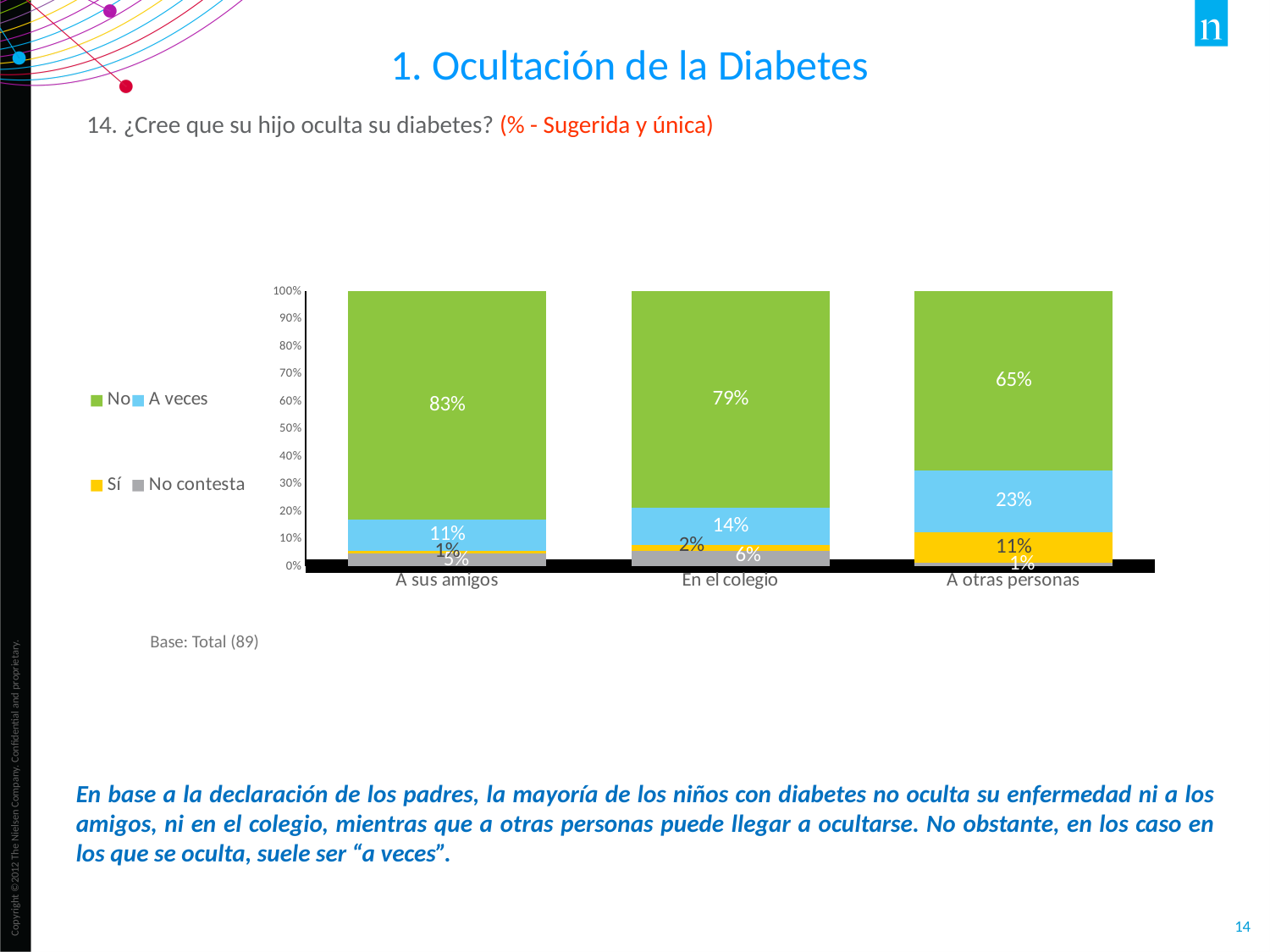
What is the value of 'No' for 'A otras personas'? 65% What type of chart is shown on the slide? Stacked bar chart What is the value of 'No' for 'A sus amigos'? 83% How many series does the chart legend list? 4 Which category has the lowest value for 'A veces'? A sus amigos Which category has the highest value for 'No'? A sus amigos What is the value of 'A veces' for 'En el colegio'? 14% How many categories are shown on the x axis of the chart? 3 Which is larger: the 'A veces' value for 'A otras personas' or for 'En el colegio'? A otras personas What is the difference between the 'No' values for 'A sus amigos' and 'A otras personas'? 18% What is the value of 'Sí' for 'A otras personas'? 11% Which series is shown in green in the chart? No